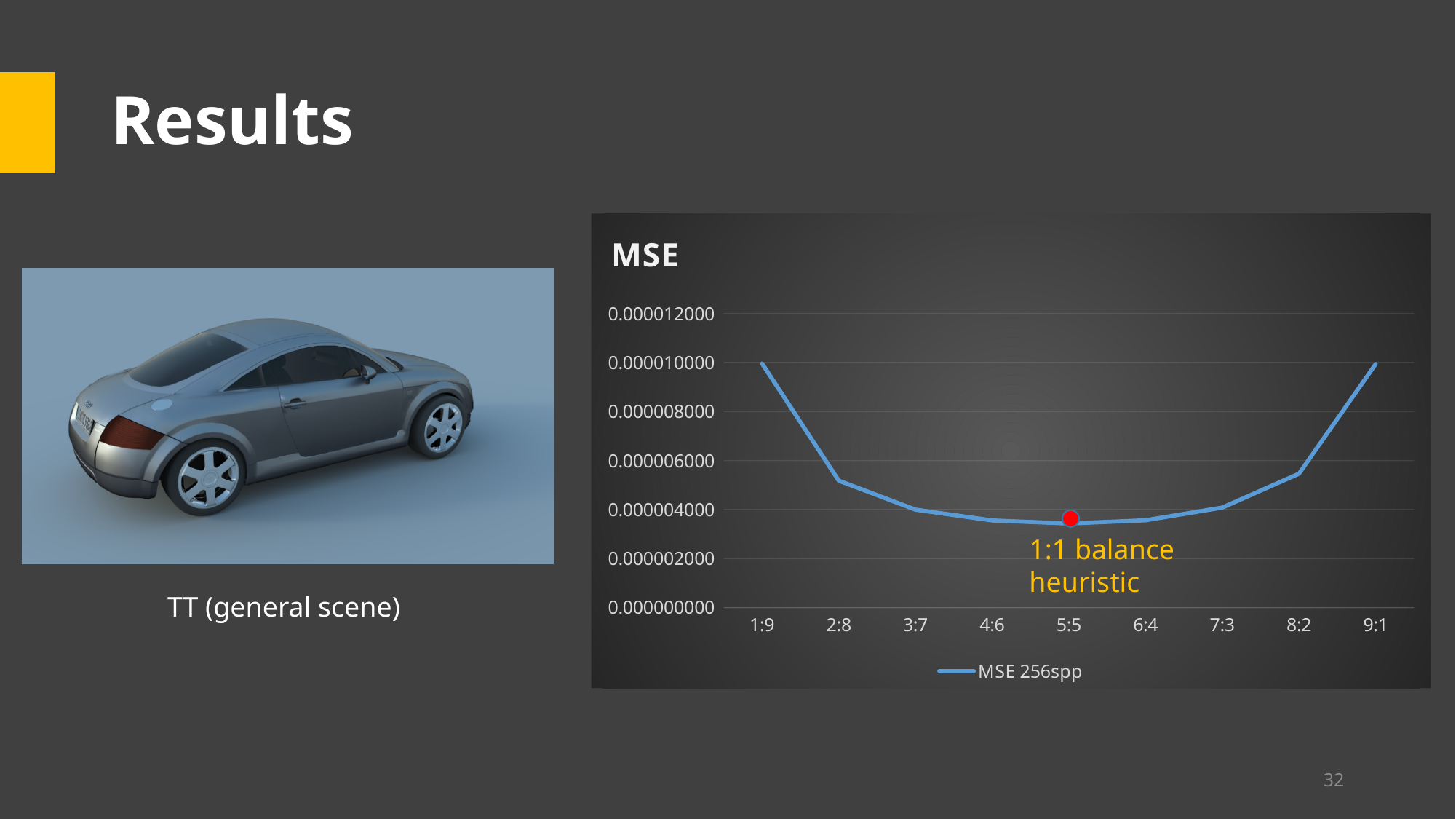
Which has the larger MSE value, 1:9 or 5:5? 1:9 What kind of chart is shown on the slide? line chart How many categories are shown on the x axis of the chart? 9 What is the title of the chart? MSE Which has the larger MSE value, 2:8 or 3:7? 2:8 Do the MSE values rise or fall from 1:9 to 5:5 along the x axis? fall Is the MSE value for 9:1 greater or less than 0.000008000? greater What is the name of the series in the chart legend? MSE 256spp How many series does the chart legend list? 1 Is the MSE value for 5:5 greater or less than 0.000004000? less Is the MSE value for 2:8 greater or less than 0.000006000? less